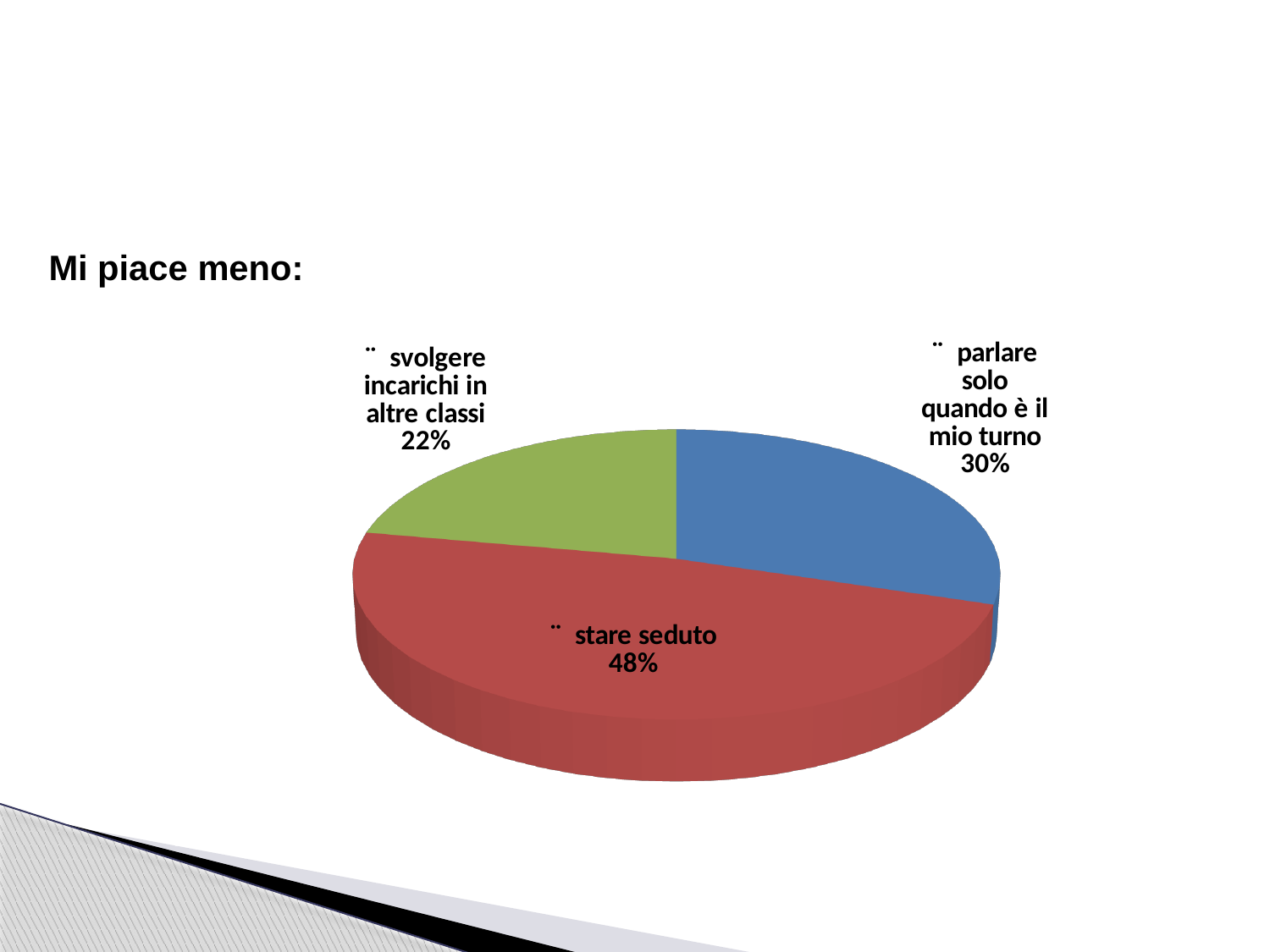
What percentage of the pie is 'stare seduto'? 48% What is the heading text above the pie chart? Mi piace meno: What kind of chart is shown on the slide? pie chart What is the difference in percentage points between 'parlare solo quando è il mio turno' and 'svolgere incarichi in altre classi'? 8 What is the difference in percentage points between 'stare seduto' and 'parlare solo quando è il mio turno'? 18 Which slice of the pie is the largest? stare seduto What colour is the 'stare seduto' slice? red What percentage of the pie is 'parlare solo quando è il mio turno'? 30% What percentage of the pie is 'svolgere incarichi in altre classi'? 22% Which slice of the pie is the smallest? svolgere incarichi in altre classi Which is larger: 'parlare solo quando è il mio turno' or 'svolgere incarichi in altre classi'? parlare solo quando è il mio turno How many slices does the pie chart have? 3